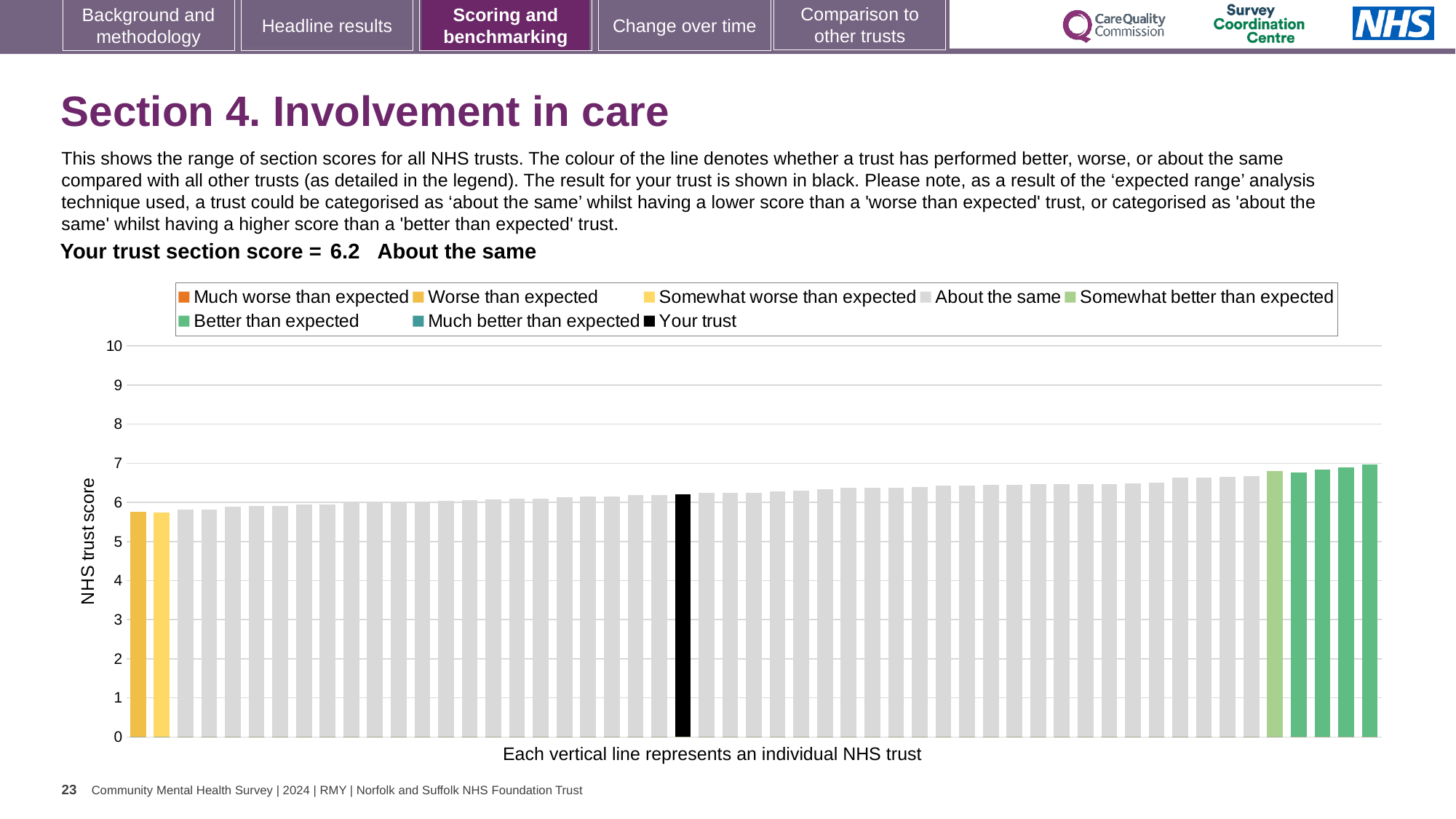
What kind of chart is shown on the slide? bar chart How many bars are coloured in the yellow 'worse than expected' shades? 2 Is the value of the rightmost bar greater or less than 6? greater What colour is used for the bar representing your trust? black What is the trust's section score for Section 4, Involvement in care? 6.2 Is the value of the leftmost bar greater or less than 6? less What is the label on the vertical axis of the chart? NHS trust score Which performance category is the trust's section score placed in? About the same How many bars are coloured as 'Better than expected' (dark green)? 4 Is the value of the black 'Your trust' bar greater or less than 6? greater How many entries does the chart legend list? 8 Do the bar heights rise or fall from left to right across the chart? rise